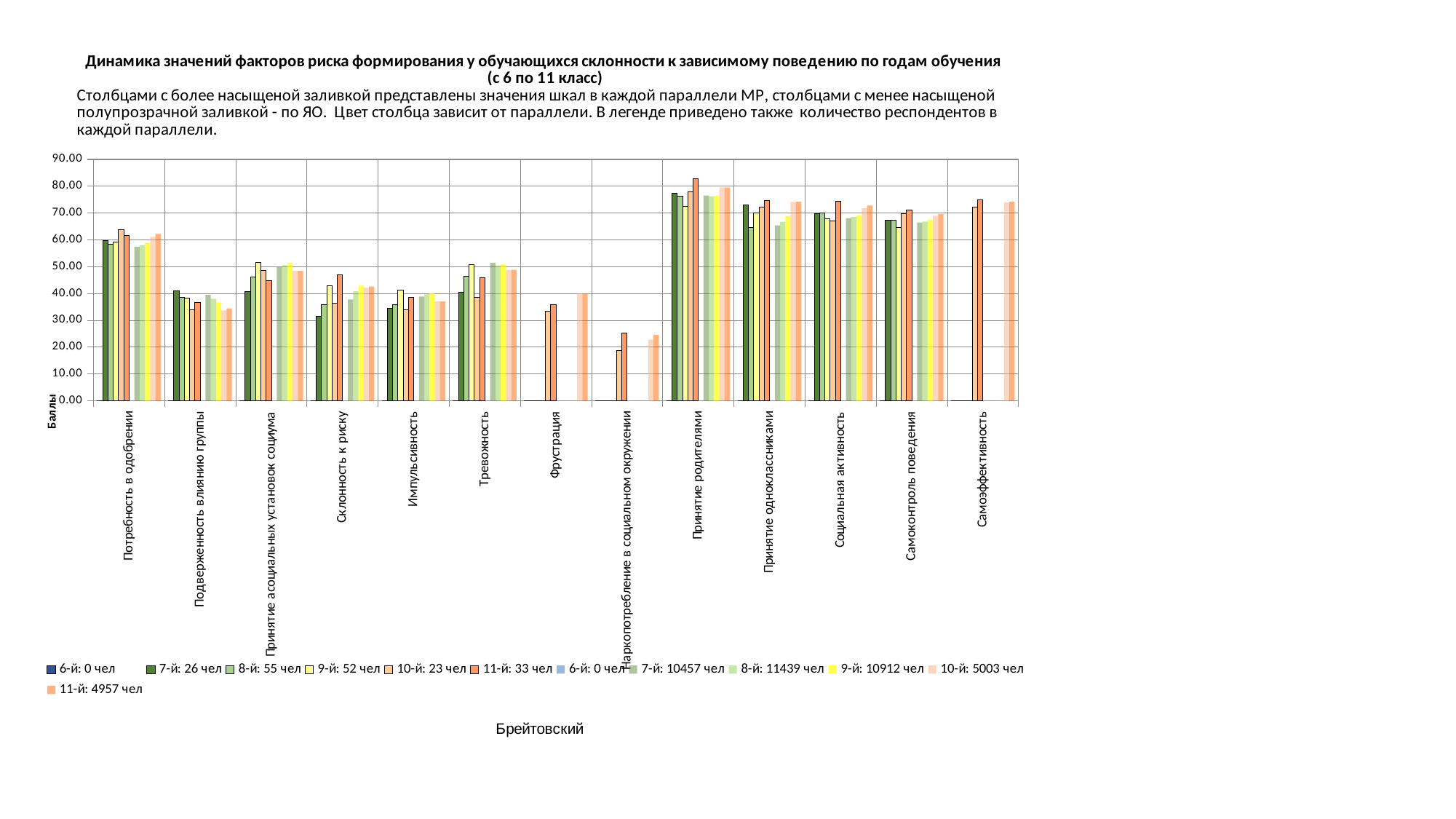
For the series 11-й: 33 чел, which is larger: the value for Принятие родителями or the value for Фрустрация? Принятие родителями Which category has the highest bars in the chart? Принятие родителями How many categories are shown along the x axis of the chart? 13 What kind of chart is shown on the slide? bar chart Is the value for Наркопотребление в социальном окружении in the series 11-й: 33 чел greater or less than 30? less According to the legend, how many respondents are in the 7-й МР series? 26 чел Is the value for Принятие родителями in the series 11-й: 33 чел greater or less than 80? greater How many series does the chart legend list? 12 Is the value for Самоэффективность in the series 11-й: 33 чел greater or less than 70? greater What is the label of the vertical axis of the chart? Баллы Which category has the lowest bars in the chart? Наркопотребление в социальном окружении